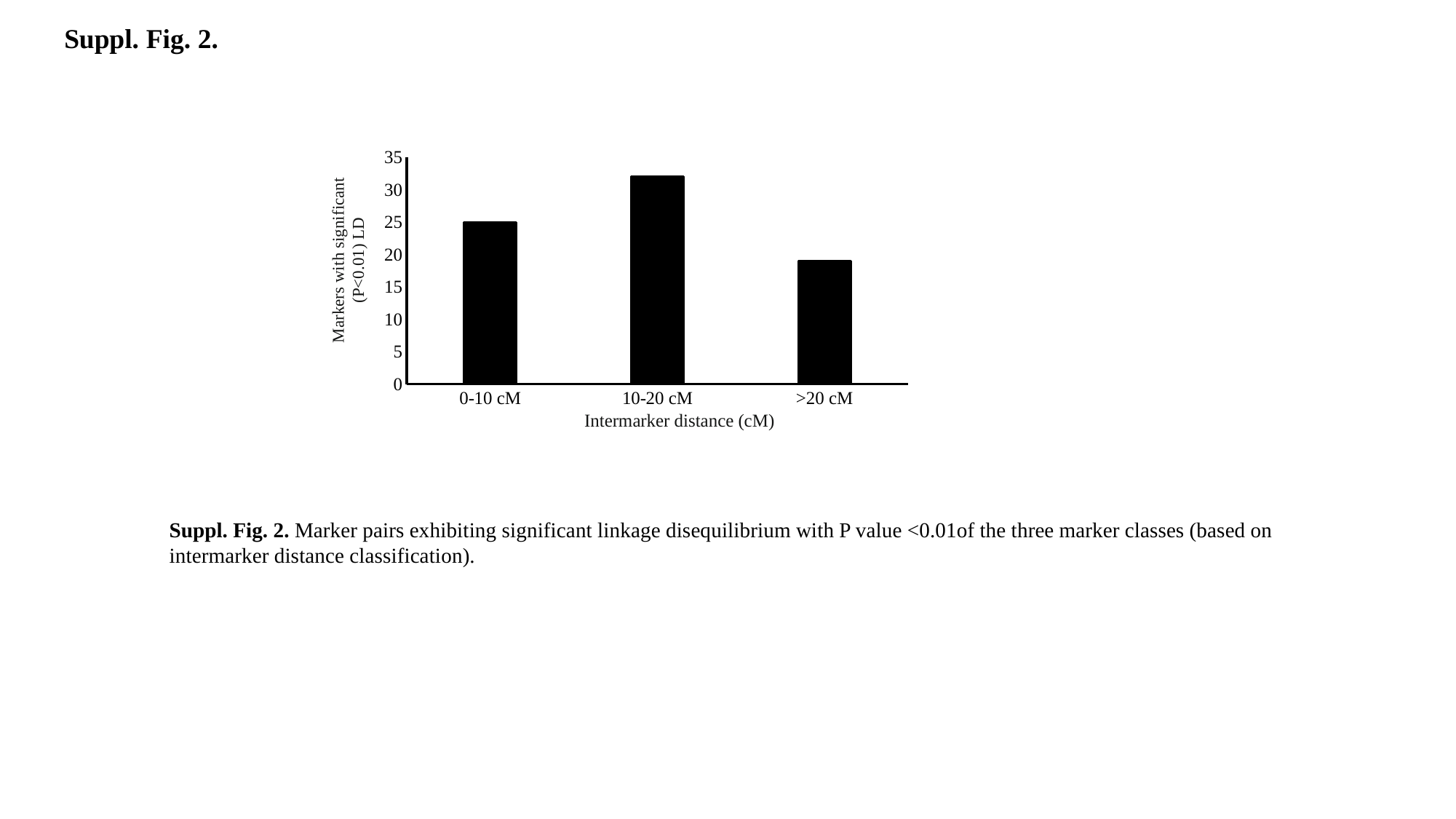
Which has more markers with significant LD, 10-20 cM or >20 cM? 10-20 cM Which intermarker distance class has the highest number of markers with significant LD? 10-20 cM Do the values rise or fall from 10-20 cM to >20 cM? fall What kind of chart is shown on the slide? bar chart What is the title of the x axis? Intermarker distance (cM) Which intermarker distance class has the lowest number of markers with significant LD? >20 cM How many intermarker distance categories are plotted on the x axis? 3 Is the value for 0-10 cM greater or less than 20? greater Is the value for 10-20 cM greater or less than 30? greater Which has more markers with significant LD, 0-10 cM or >20 cM? 0-10 cM What is the highest value shown on the y axis? 35